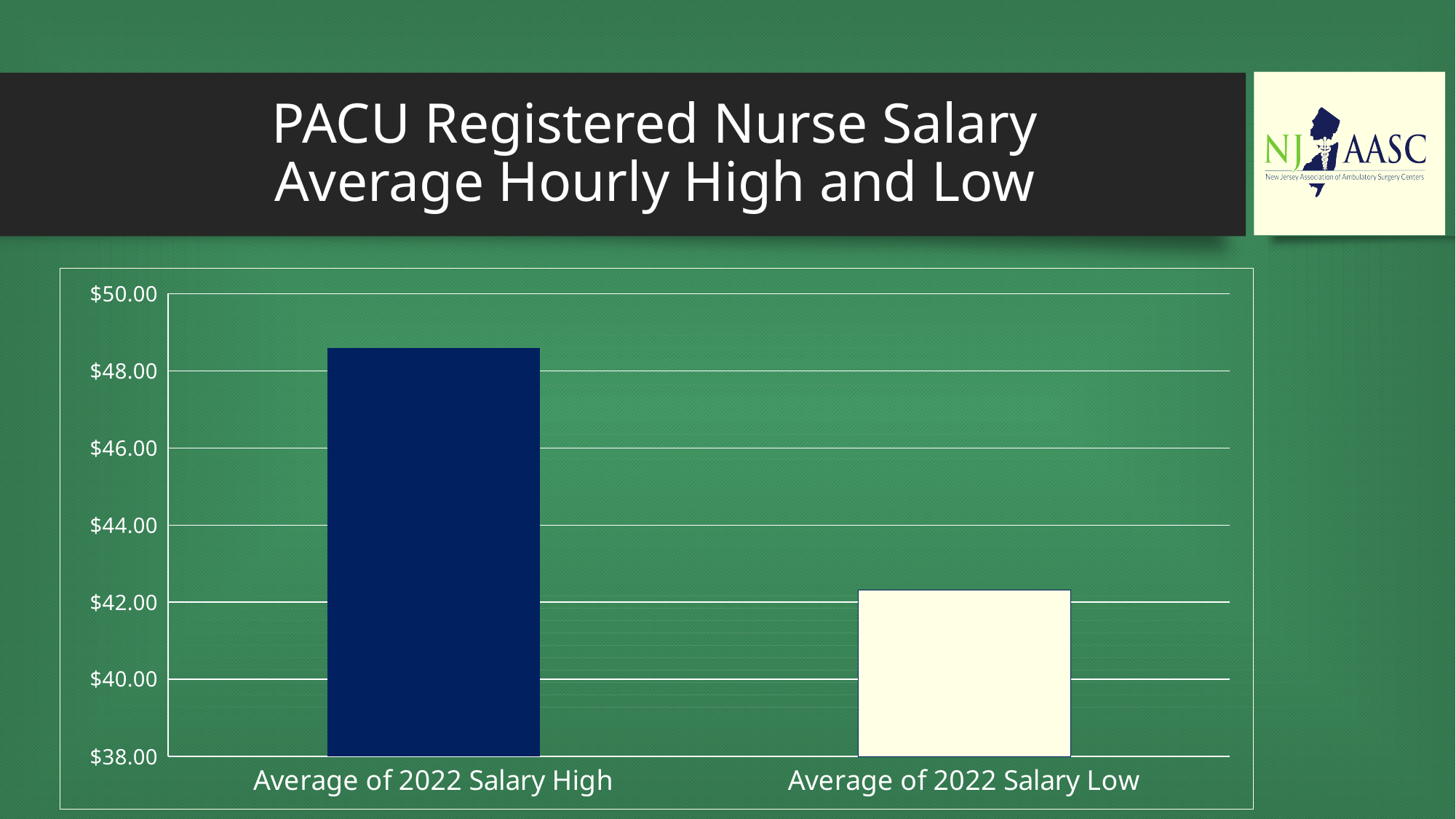
Which is larger, the value for Average of 2022 Salary High or Average of 2022 Salary Low? Average of 2022 Salary High What colour is the bar for Average of 2022 Salary High? dark blue What is the title shown above the chart on the slide? PACU Registered Nurse Salary Average Hourly High and Low How many bars are plotted in the chart? 2 What kind of chart is shown on the slide? bar chart Is the value for Average of 2022 Salary High greater or less than $50.00? less Which category has the highest value in the chart? Average of 2022 Salary High Which category has the lowest value in the chart? Average of 2022 Salary Low Is the value for Average of 2022 Salary Low greater or less than $44.00? less Is the value for Average of 2022 Salary High greater or less than $46.00? greater